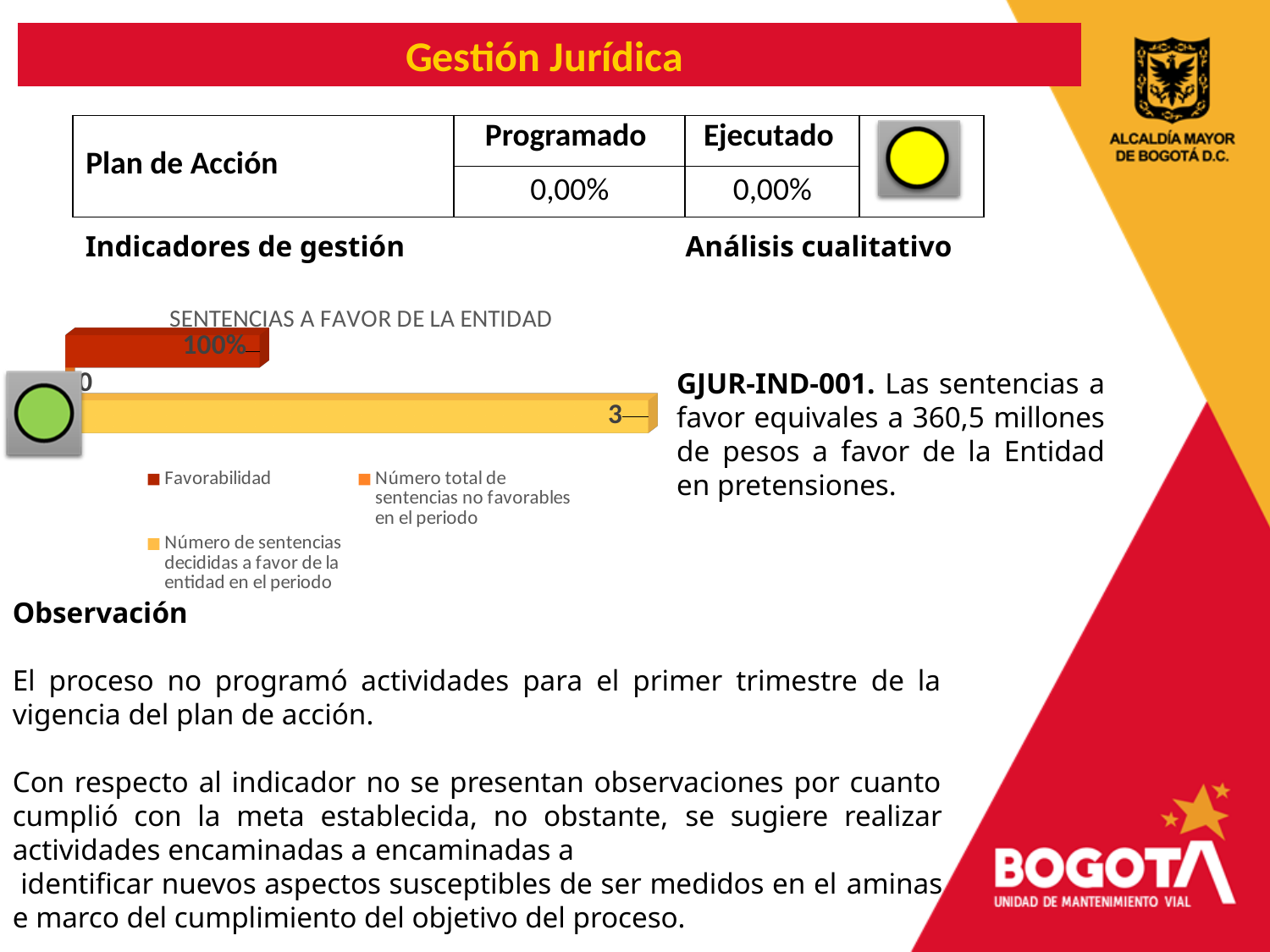
What is the value shown for "Número de sentencias decididas a favor de la entidad en el periodo"? 3 How many series does the chart legend list? 3 What is the title of the chart on the slide? SENTENCIAS A FAVOR DE LA ENTIDAD What is the value shown for Favorabilidad in the chart? 100% Which legend entry in the chart is shown in dark red? Favorabilidad What kind of chart is shown under "Indicadores de gestión"? bar chart How many bars have a data label in the chart? 3 What is the value shown for "Número total de sentencias no favorables en el periodo"? 0 Which is larger: the number of sentencias decididas a favor de la entidad or the number of sentencias no favorables? Número de sentencias decididas a favor de la entidad en el periodo What is the difference between the number of sentencias decididas a favor de la entidad and the number of sentencias no favorables? 3